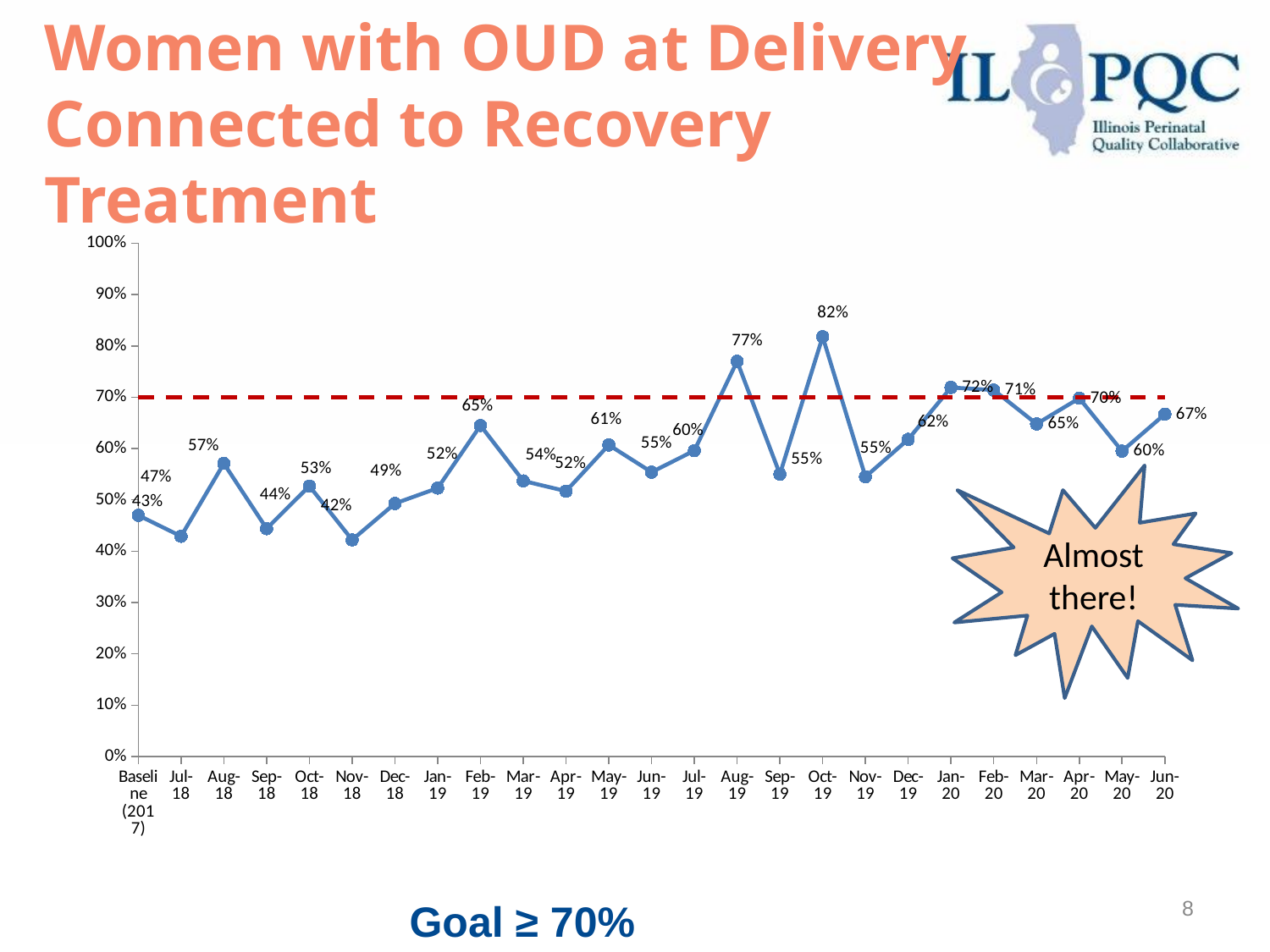
Which is larger, the value for Aug-19 or the value for Jan-20? Aug-19 What is the difference between the Jun-20 value and the Baseline (2017) value? 20% Which month has the lowest value? Nov-18 What is the difference between the values for Oct-19 and Sep-19? 27% What is the value for Feb-19? 65% How many data points are plotted on the chart? 25 What type of chart is shown on the slide? line chart Is the value for Nov-18 greater or less than 50%? less What goal value does the dashed horizontal line represent? 70% What is the value for Jun-20? 67% What is the value for Oct-19? 82% Which month has the highest value? Oct-19